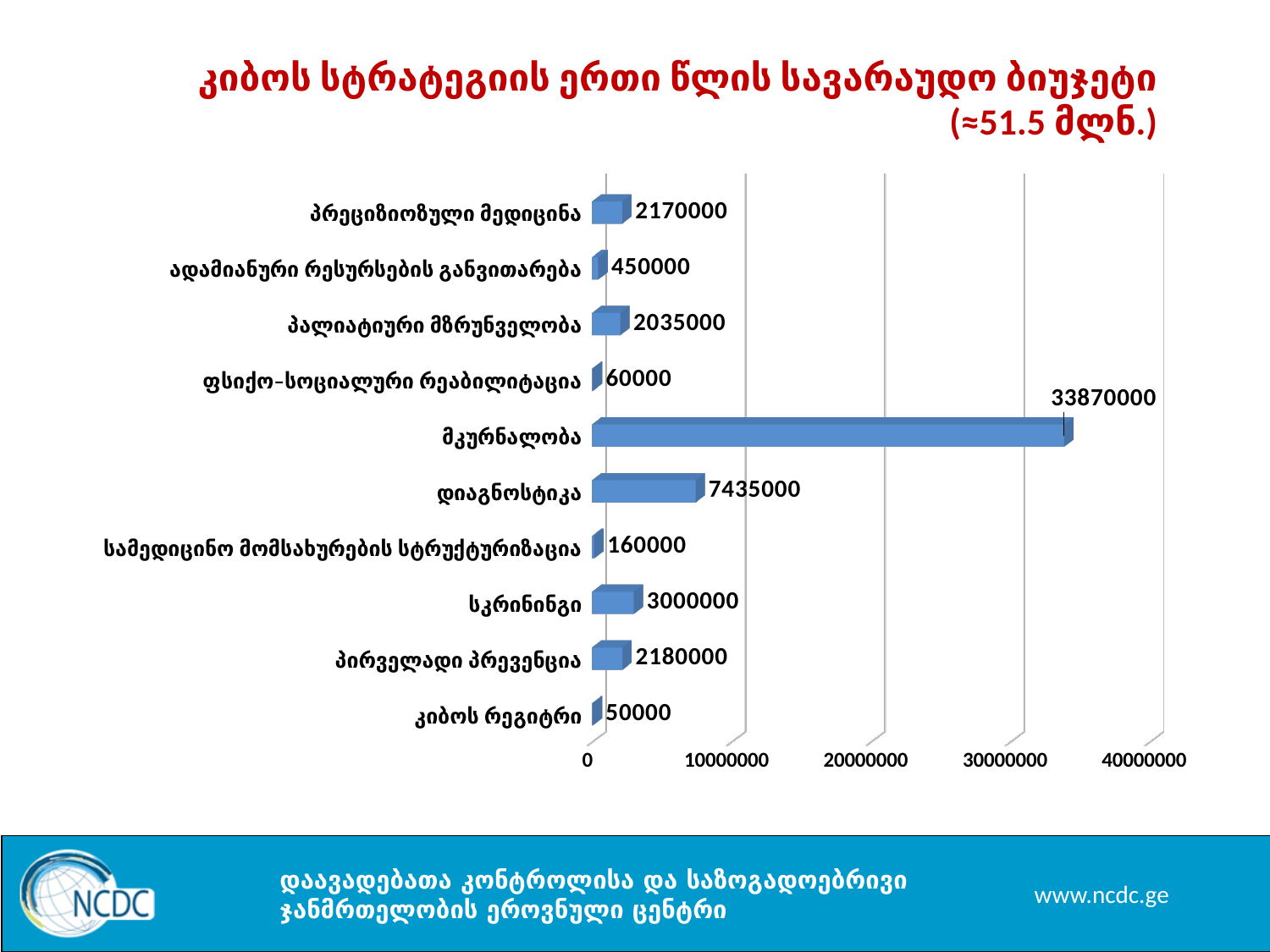
What is the difference between the values for მკურნალობა and დიაგნოსტიკა? 26435000 Is the value for მკურნალობა greater or less than 30000000? greater What is the value for სკრინინგი? 3000000 Which is larger, the value for პალიატიური მზრუნველობა or the value for ადამიანური რესურსების განვითარება? პალიატიური მზრუნველობა What is the value for მკურნალობა? 33870000 What is the value for კიბოს რეგისტრი? 50000 What is the difference between the values for სკრინინგი and პირველადი პრევენცია? 820000 How many categories are shown in the chart? 10 Which category has the lowest value? კიბოს რეგიტრი What is the value for დიაგნოსტიკა? 7435000 What kind of chart is shown on the slide? bar chart Which category has the highest value? მკურნალობა